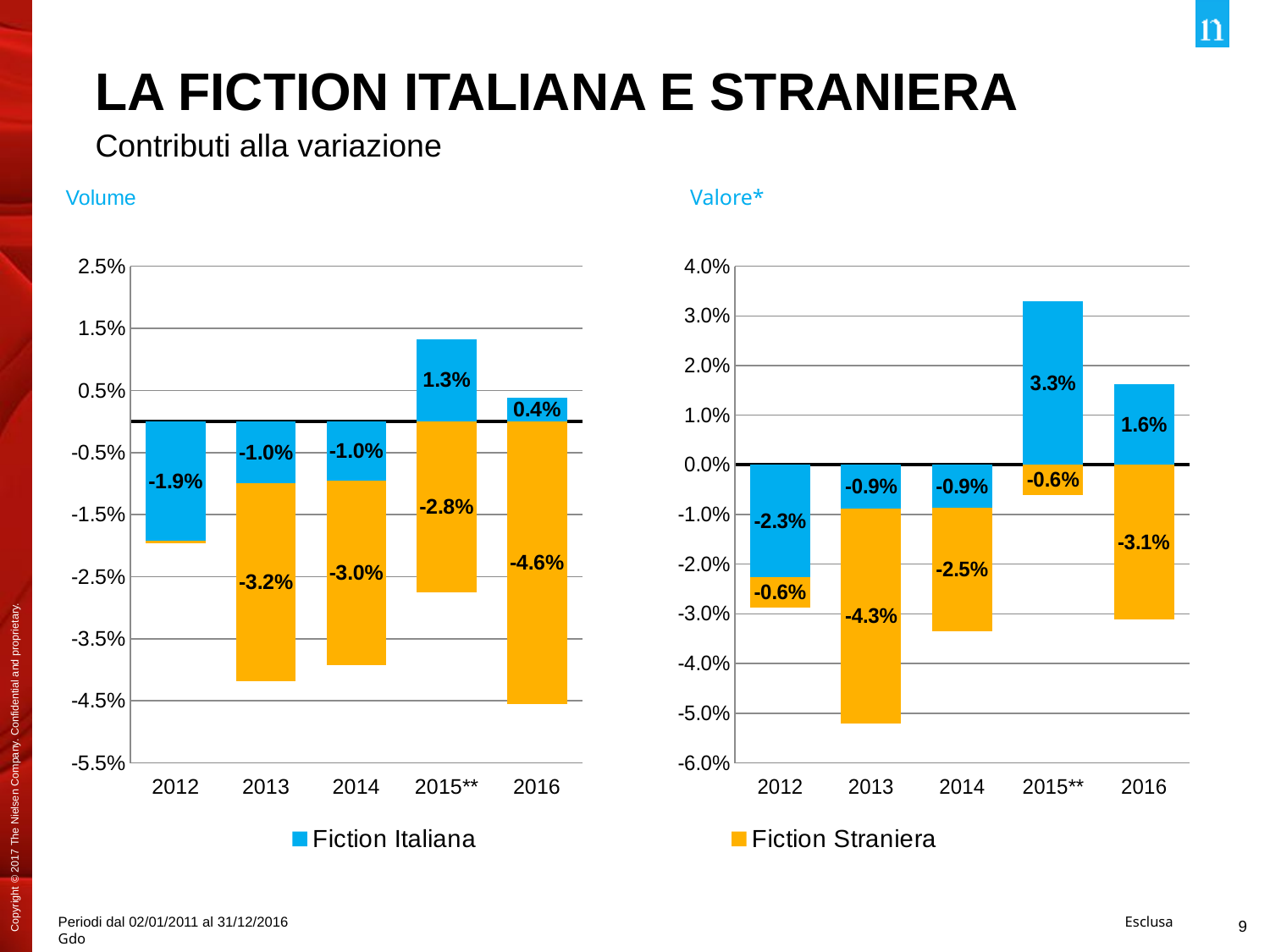
What type of chart is the Volume chart? Stacked bar chart In the Valore* chart, what is the value for Fiction Italiana in 2015**? 3.3% In the Volume chart, what is the value for Fiction Straniera in 2016? -4.6% In the Valore* chart, what is the value for Fiction Straniera in 2013? -4.3% In the Valore* chart, what is the total of the stacked bar for 2016? -1.5% In the Volume chart, what is the value for Fiction Italiana in 2012? -1.9% How many years are shown on the x axis of the Valore* chart? 5 In the Volume chart, which is larger: the Fiction Straniera value for 2013 or for 2014? 2014 In the Volume chart, what is the value for Fiction Italiana in 2015**? 1.3% In the Valore* chart, what is the difference between the Fiction Italiana values for 2015** and 2016? 1.7% In the Volume chart, which year has the lowest value for Fiction Straniera? 2016 In the Valore* chart, which year has the highest value for Fiction Italiana? 2015**